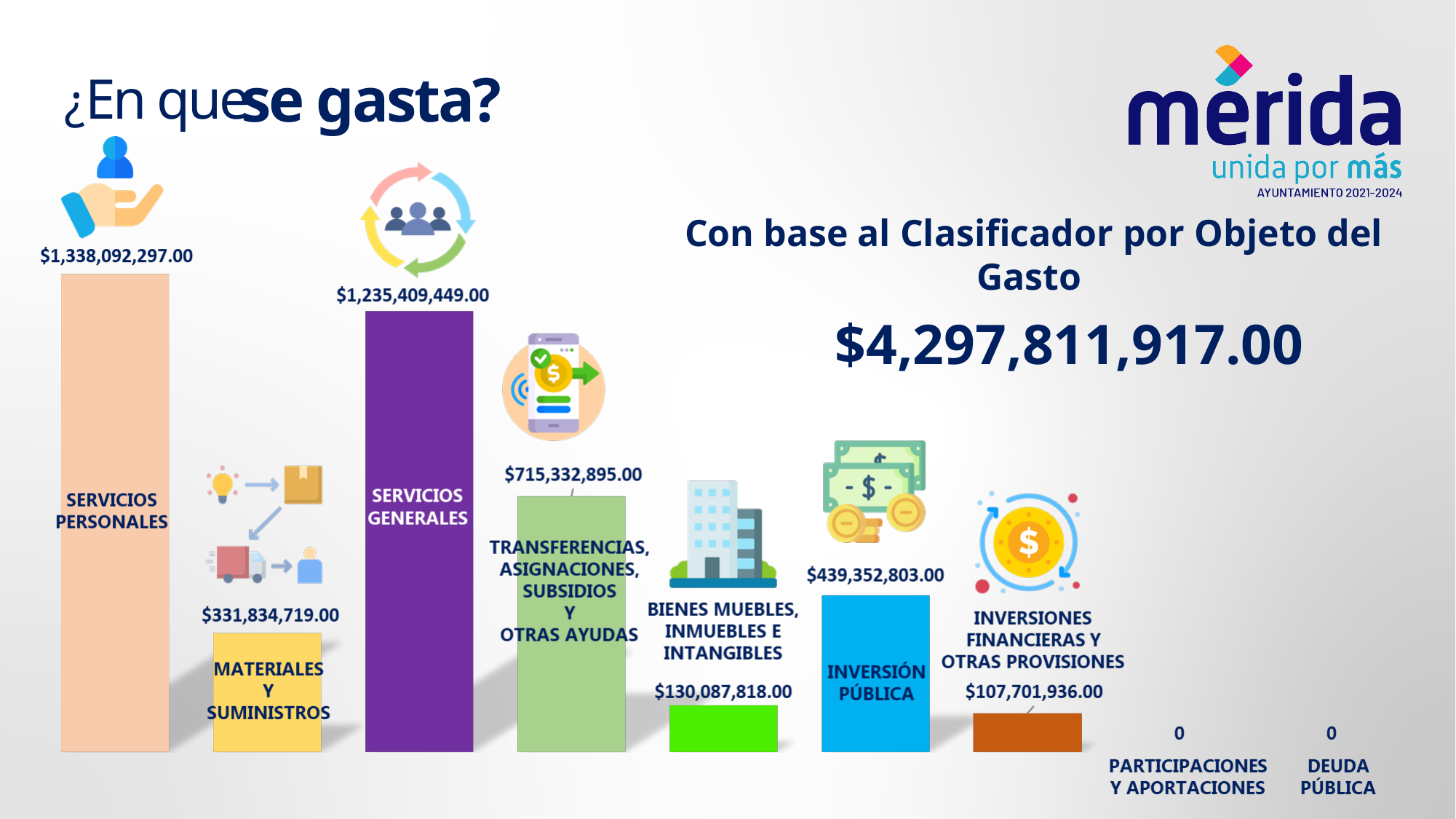
Which category has the highest value? Servicios Personales Which is larger, Bienes Muebles, Inmuebles e Intangibles or Inversiones Financieras y Otras Provisiones? Bienes Muebles, Inmuebles e Intangibles What is the value shown for Servicios Personales? $1,338,092,297.00 What is the value shown for Transferencias, Asignaciones, Subsidios y Otras Ayudas? $715,332,895.00 Which category has the lowest non-zero value? Inversiones Financieras y Otras Provisiones What is the difference between Inversión Pública and Materiales y Suministros? $107,518,084.00 What total amount is shown on the slide for the Clasificador por Objeto del Gasto? $4,297,811,917.00 What is the value shown for Deuda Pública? 0 What is the difference between Servicios Personales and Servicios Generales? $102,682,848.00 What is the value shown for Inversión Pública? $439,352,803.00 How many spending categories are shown in the chart? 9 What kind of chart is shown on the slide? Bar chart